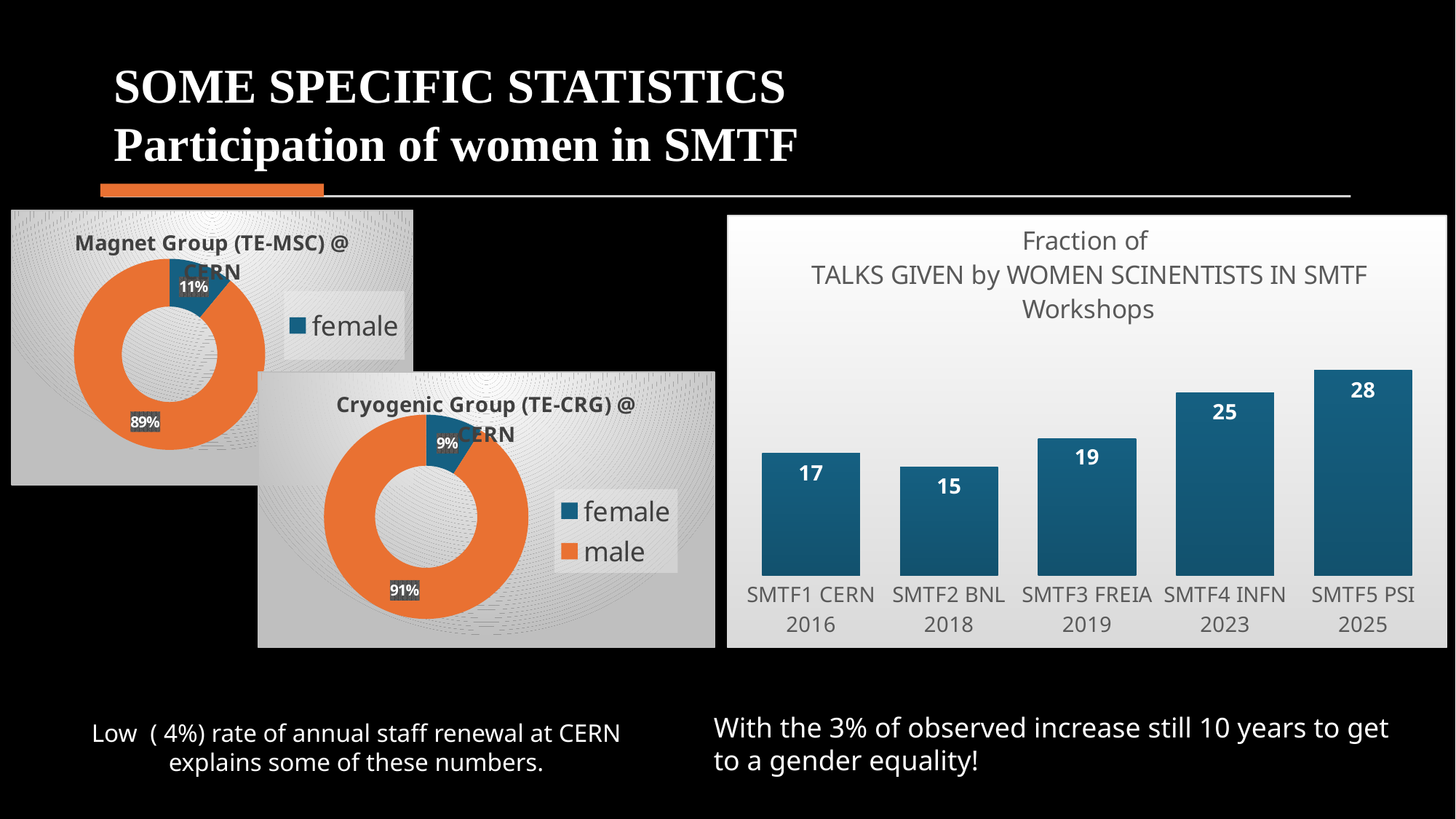
In the 'Fraction of TALKS GIVEN by WOMEN SCIENTISTS IN SMTF Workshops' chart, which is larger: the value for SMTF3 FREIA 2019 or SMTF4 INFN 2023? SMTF4 INFN 2023 In the 'Fraction of TALKS GIVEN by WOMEN SCIENTISTS IN SMTF Workshops' chart, which workshop has the lowest value? SMTF2 BNL 2018 In the 'Fraction of TALKS GIVEN by WOMEN SCIENTISTS IN SMTF Workshops' chart, what is the difference between the values for SMTF5 PSI 2025 and SMTF1 CERN 2016? 11 How many entries does the legend of the 'Cryogenic Group (TE-CRG) @ CERN' chart list? 2 Which chart has the larger female share: 'Magnet Group (TE-MSC) @ CERN' or 'Cryogenic Group (TE-CRG) @ CERN'? Magnet Group (TE-MSC) @ CERN In the 'Fraction of TALKS GIVEN by WOMEN SCIENTISTS IN SMTF Workshops' chart, what is the value for SMTF5 PSI 2025? 28 What kind of chart is the 'Fraction of TALKS GIVEN by WOMEN SCIENTISTS IN SMTF Workshops' chart? Bar chart In the 'Fraction of TALKS GIVEN by WOMEN SCIENTISTS IN SMTF Workshops' chart, which workshop has the highest value? SMTF5 PSI 2025 In the 'Fraction of TALKS GIVEN by WOMEN SCIENTISTS IN SMTF Workshops' chart, what is the value for SMTF2 BNL 2018? 15 In the 'Magnet Group (TE-MSC) @ CERN' chart, what share is female? 11% How many workshops are shown in the 'Fraction of TALKS GIVEN by WOMEN SCIENTISTS IN SMTF Workshops' chart? 5 In the 'Cryogenic Group (TE-CRG) @ CERN' chart, what share is male? 91%